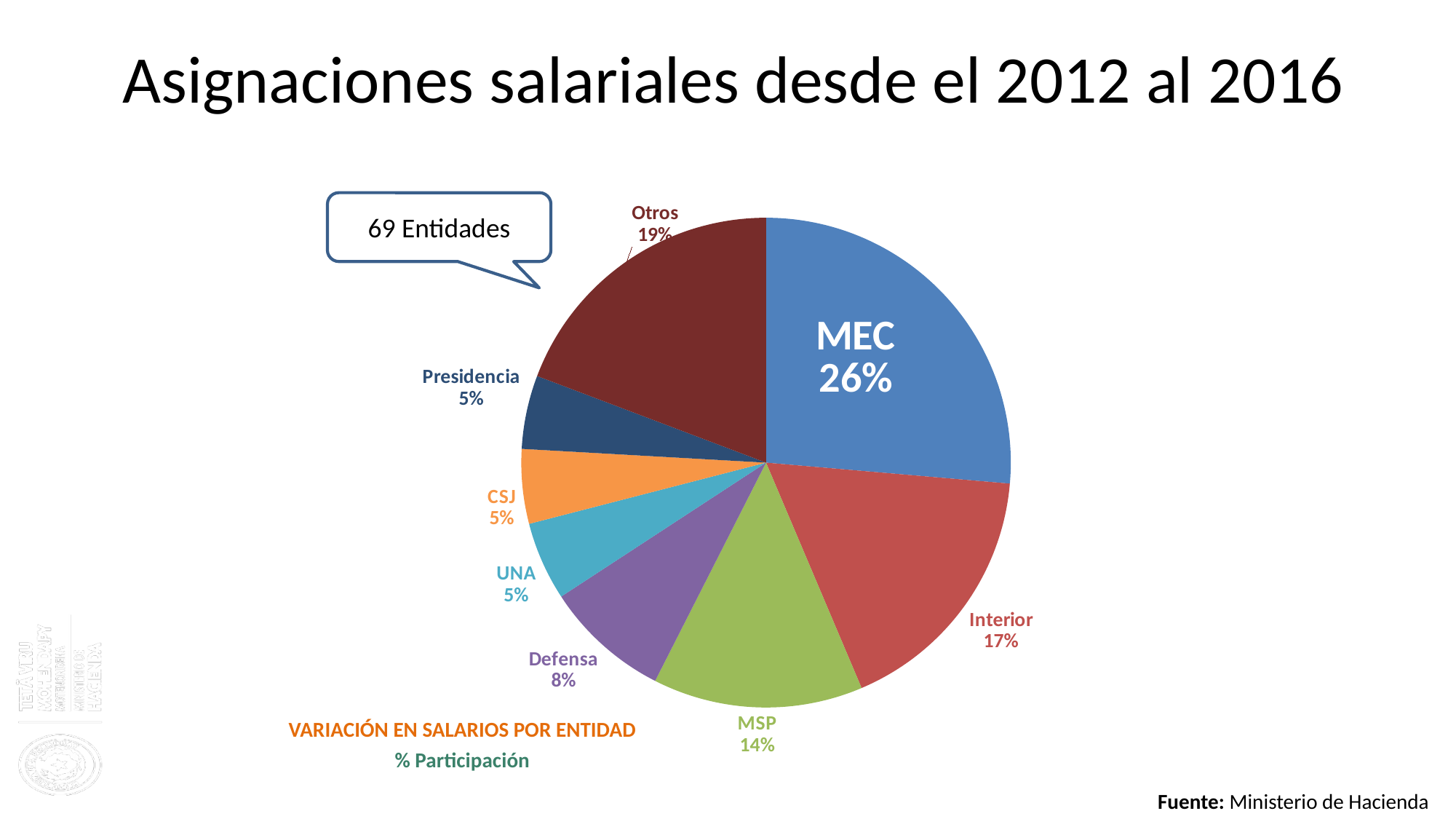
What type of chart is shown on the slide? pie chart What is the combined percentage of UNA, CSJ and Presidencia? 15% What share of the pie does MEC hold? 26% How many slices does the pie chart have? 8 What percentage is shown for Otros? 19% Which named entity has the largest slice of the pie? MEC Which is larger, the share for MSP or the share for Defensa? MSP According to the callout on the slide, how many entities are included in the chart? 69 Entidades What percentage is shown for MSP? 14% What percentage is shown for Defensa? 8% What is the difference in percentage points between MEC and Interior? 9 What percentage is shown for Interior? 17%